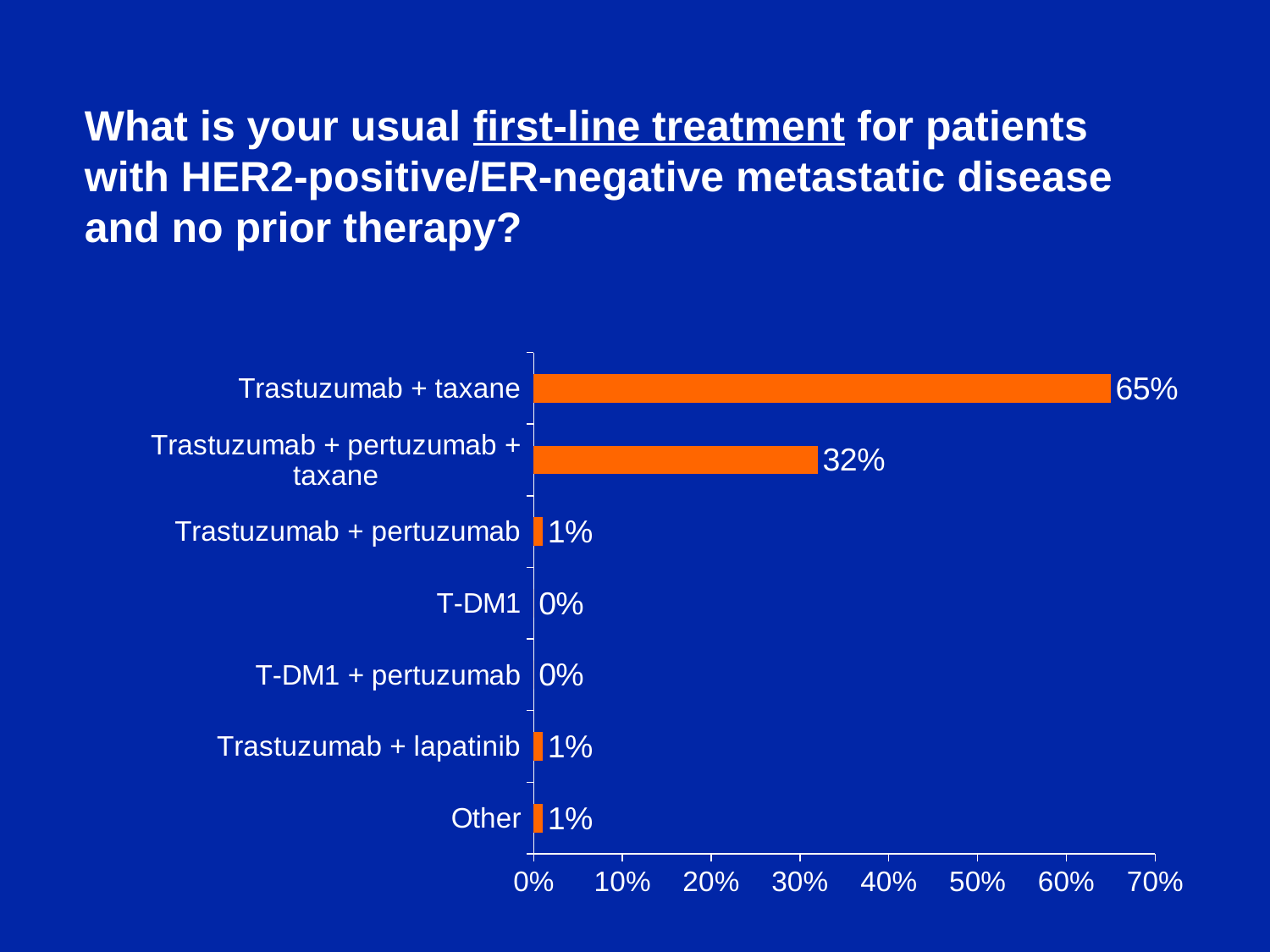
How many treatment categories are shown in the chart? 7 Which is larger, the value for Trastuzumab + pertuzumab + taxane or the value for Trastuzumab + pertuzumab? Trastuzumab + pertuzumab + taxane What is the value shown for T-DM1? 0% What kind of chart is shown on the slide? Bar chart What is the value shown for Trastuzumab + lapatinib? 1% What is the value shown for Trastuzumab + pertuzumab + taxane? 32% Is the value for Trastuzumab + taxane greater or less than 60%? greater Is the value for Trastuzumab + pertuzumab + taxane greater or less than 40%? less What is the difference in percentage points between Trastuzumab + taxane and Trastuzumab + pertuzumab + taxane? 33% Which treatment option has the highest percentage? Trastuzumab + taxane What percentage of respondents chose Trastuzumab + taxane as their usual first-line treatment? 65% What is the maximum value shown on the x axis of the chart? 70%